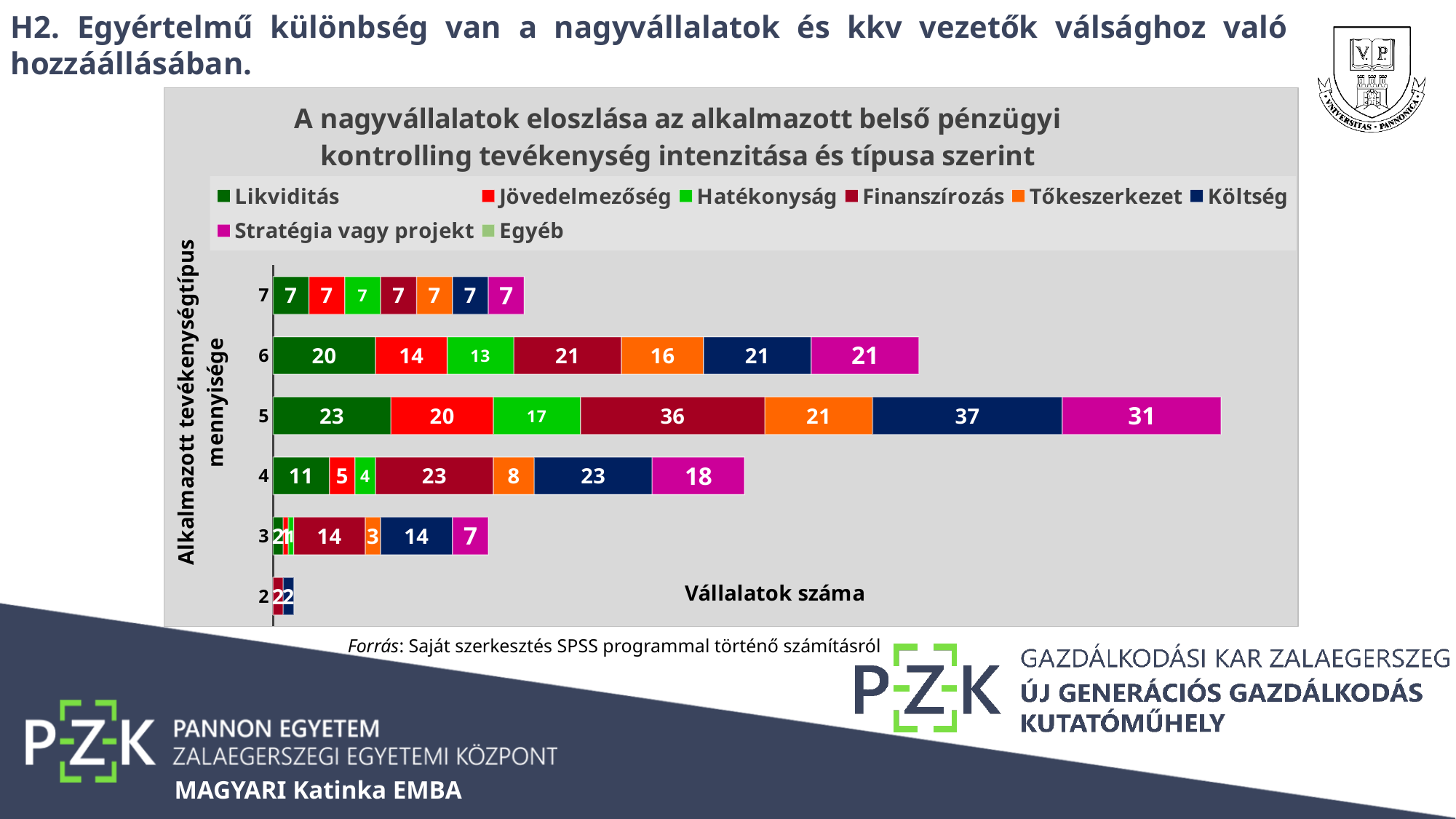
What is the Finanszírozás value for category 4? 23 How many series does the legend list? 8 Which category has the shortest stacked bar? 2 What is the Stratégia vagy projekt value for category 6? 21 What is the Hatékonyság value for category 5? 17 Which category has the longest stacked bar? 5 What kind of chart is shown on the slide? Stacked bar chart What is the total of the stacked bar for category 7? 49 What is the Költség value for category 5? 37 What is the total of the stacked bar for category 5? 185 Which is larger for category 4: the Likviditás value or the Stratégia vagy projekt value? Stratégia vagy projekt What is the difference between the Finanszírozás value for category 5 and the Finanszírozás value for category 6? 15